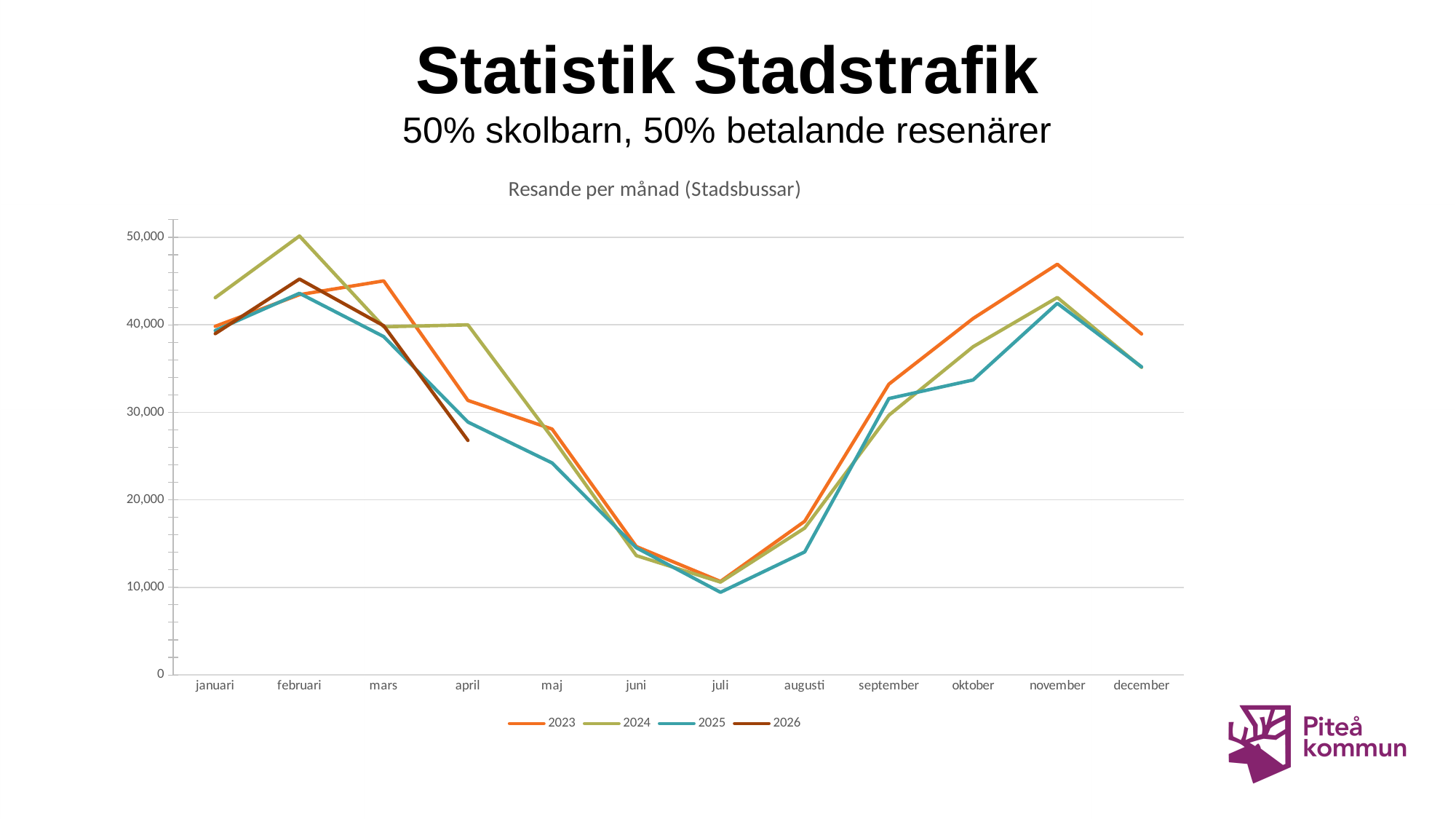
Which series stops at april instead of continuing through december? 2026 Does the 2025 series rise or fall from juli to november? rise In februari, which series has the larger value, 2023 or 2024? 2024 Is the value for 2026 in april greater or less than 30,000? less How many series does the legend list? 4 What kind of chart is shown on the slide? line chart Is the value for 2023 in juli greater or less than 20,000? less In which month does the 2024 series reach its highest value? februari In which month does the 2025 series reach its lowest value? juli How many months are shown on the x axis? 12 What is the title of the chart? Resande per månad (Stadsbussar) Is the value for 2024 in februari greater or less than 40,000? greater